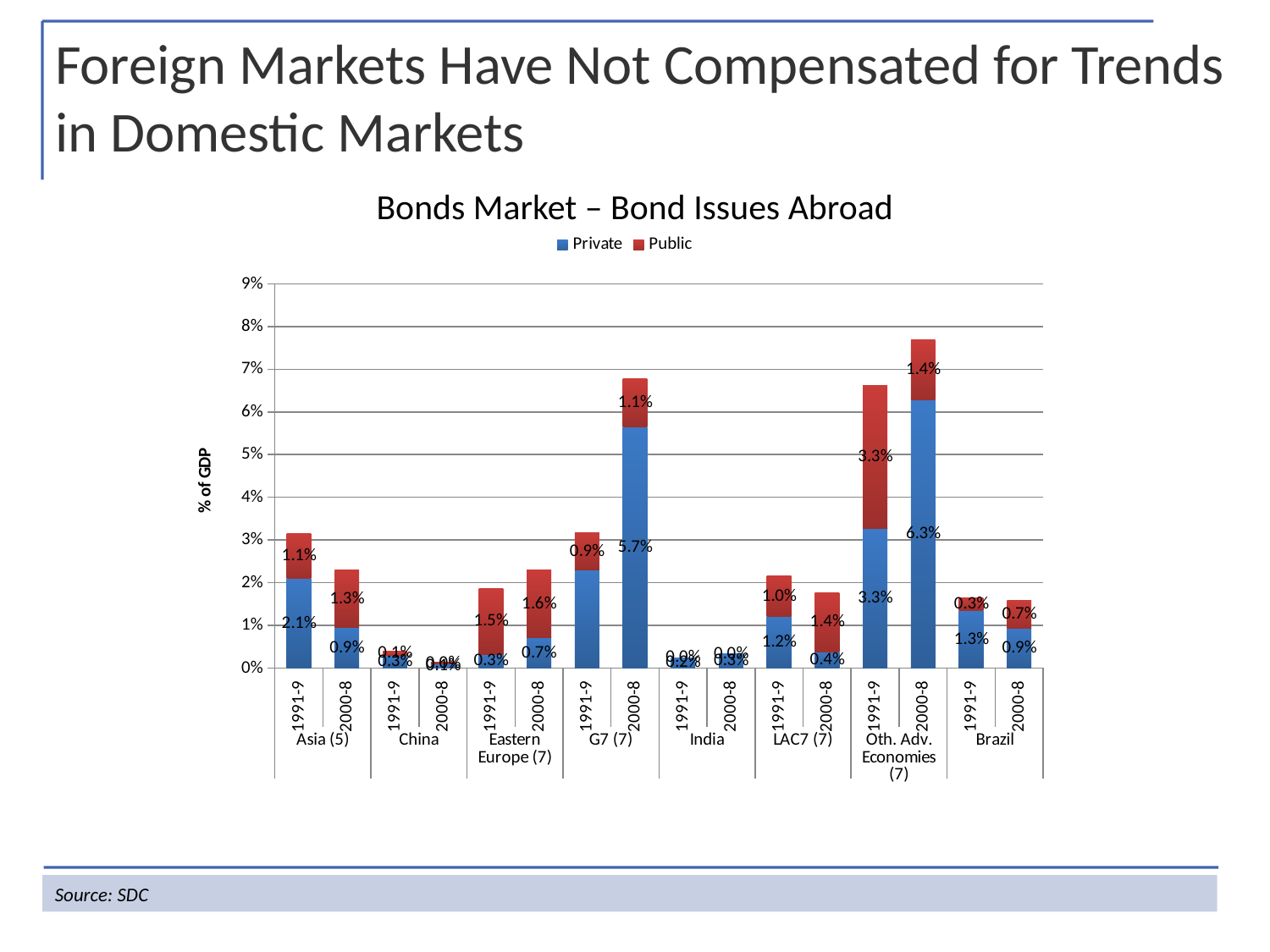
Is the total value for G7 (7) in 2000-8 greater or less than 6%? greater What is the total of the stacked bar for Asia (5) in 1991-9? 3.2% How many series does the legend list? 2 What is the difference between the Private value for Oth. Adv. Economies (7) in 2000-8 and in 1991-9? 3.0% What kind of chart is shown? Stacked bar chart Which bar has the highest total value? Oth. Adv. Economies (7) 2000-8 What is the Public value for Oth. Adv. Economies (7) in 2000-8? 1.4% What is the Public value for Eastern Europe (7) in 2000-8? 1.6% How many region groups are shown on the x axis? 8 Which is larger, the Private value for Asia (5) in 1991-9 or in 2000-8? 1991-9 What is the Private value for G7 (7) in 2000-8? 5.7% What is the total of the stacked bar for Oth. Adv. Economies (7) in 2000-8? 7.7%